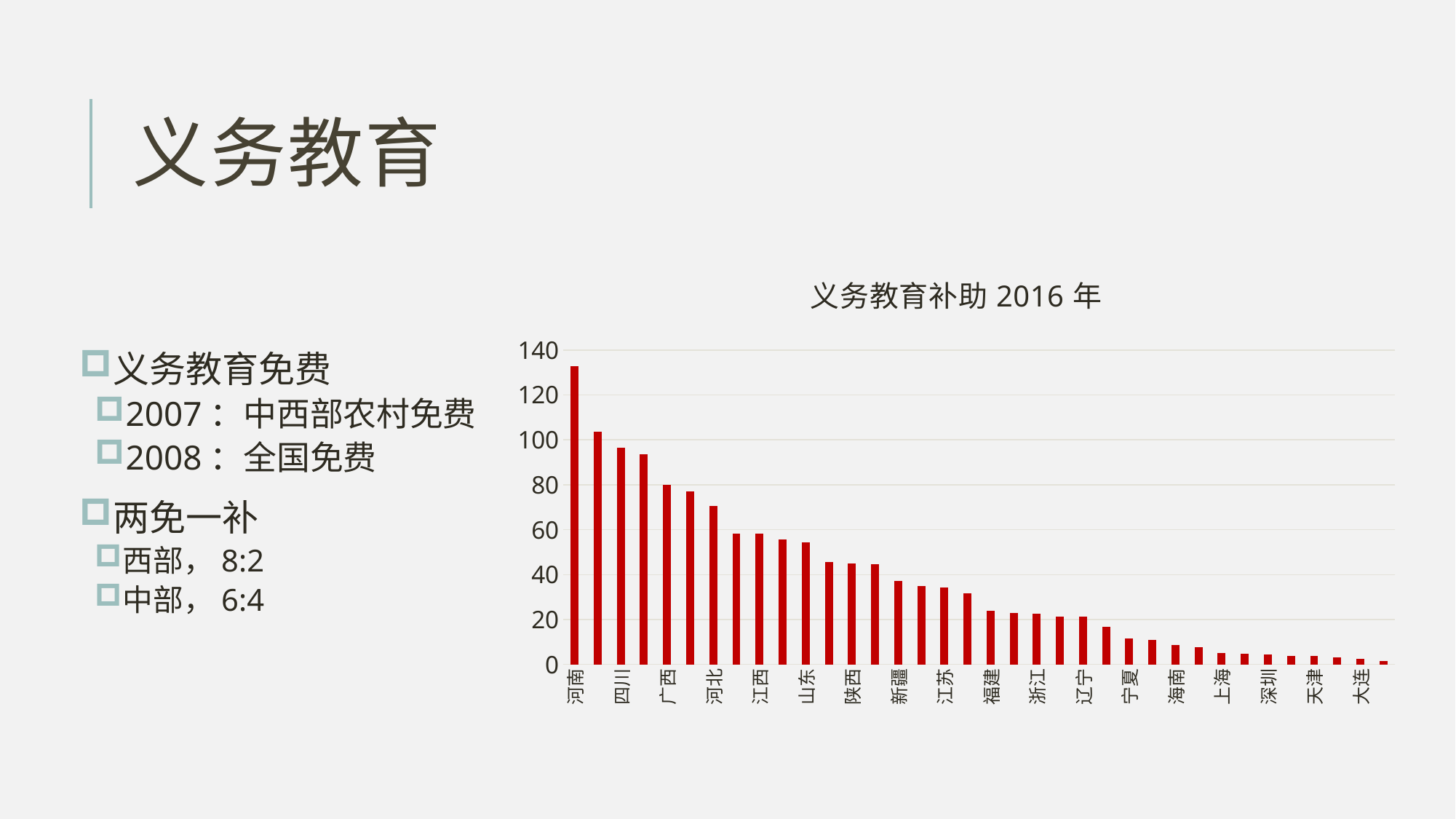
Is the value for 江苏 greater or less than 40? less Which category has the highest value in the chart? 河南 Is the value for 宁夏 greater or less than 20? less Is the value for 陕西 greater or less than 60? less What kind of chart is shown on the slide? bar chart What is the title of the chart? 义务教育补助 2016 年 Which has the larger value, 大连 or 山东? 山东 Do the values rise or fall from left to right along the x axis? fall What colour are the bars in the chart? red Which has the larger value, 河北 or 江苏? 河北